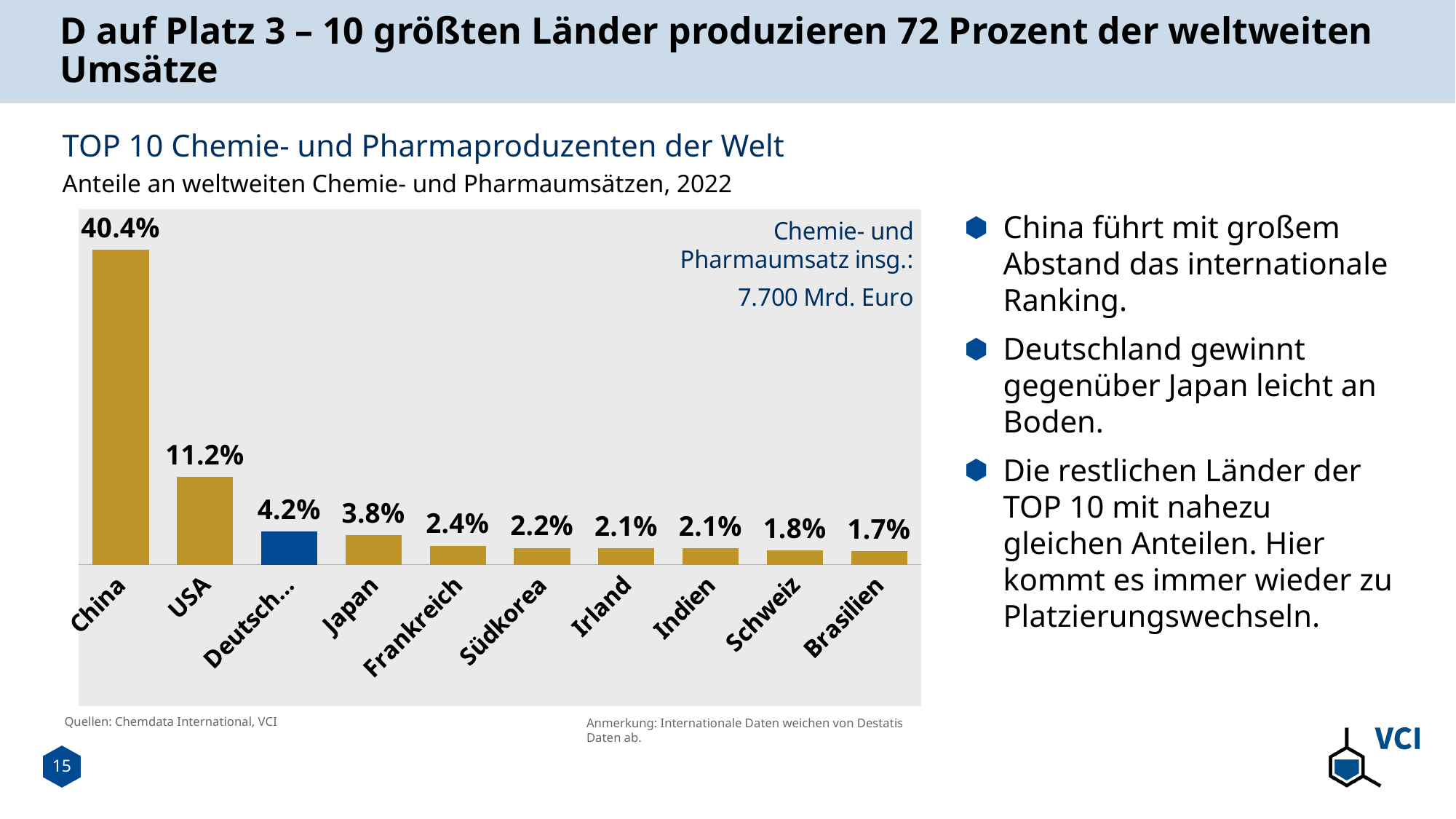
What type of chart is shown on the slide? Bar chart Which country has the highest share in the chart? China What is the value shown for the USA? 11.2% How many countries are shown in the chart? 10 Which has the larger share, Südkorea or Schweiz? Südkorea What value is printed above the bar for Japan? 3.8% What is the share shown for Frankreich? 2.4% What total chemical and pharmaceutical sales figure is noted in the chart area? 7.700 Mrd. Euro What share of worldwide chemical and pharmaceutical sales does China hold in the chart? 40.4% What is the difference between the blue bar (Deutsch...) and Japan? 0.4% What is the difference between the shares of China and the USA? 29.2% Which country has the lowest share in the chart? Brasilien